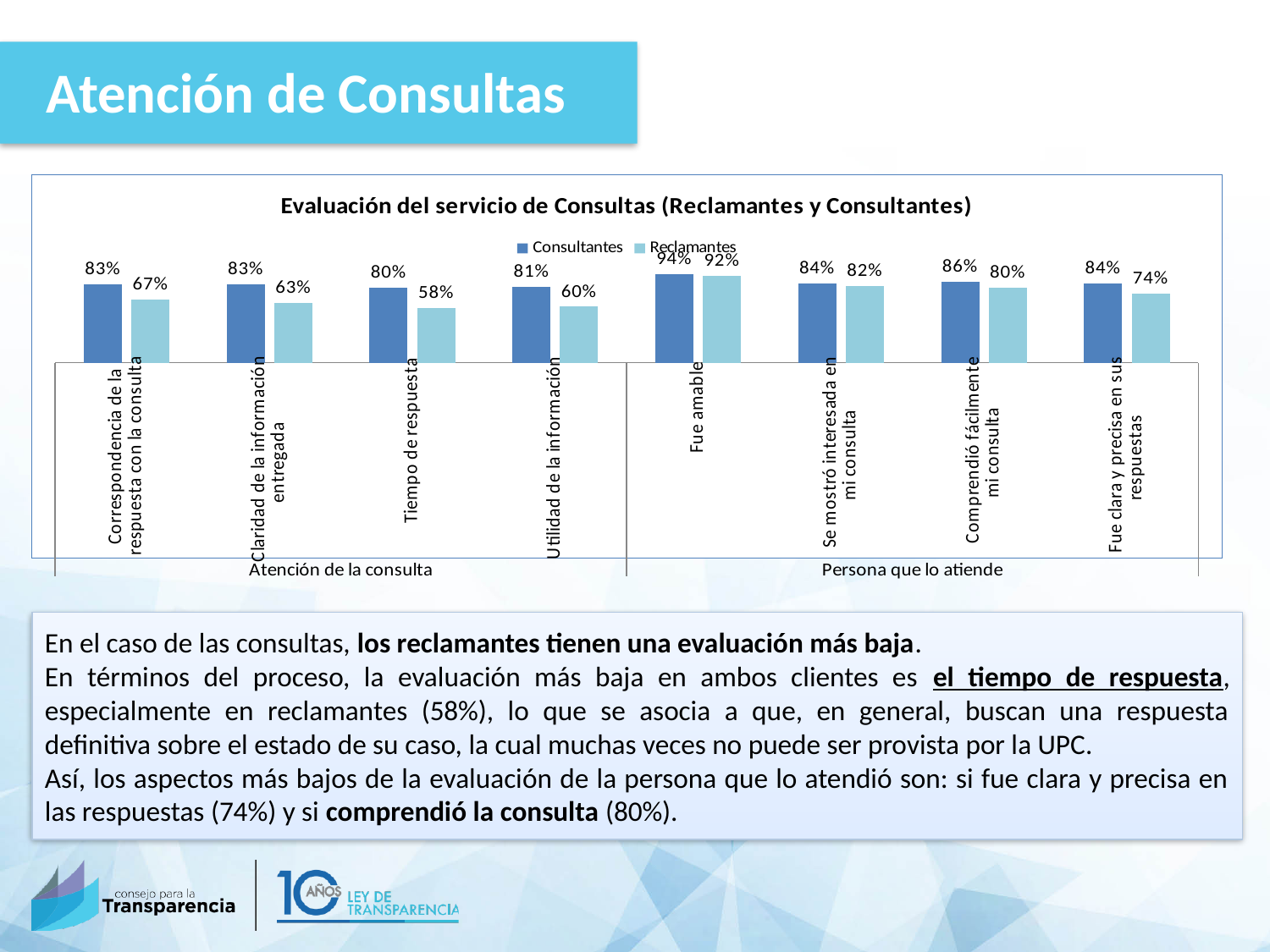
Which category has the lowest Reclamantes value? Tiempo de respuesta How many series does the legend list? 2 What is the title of the chart? Evaluación del servicio de Consultas (Reclamantes y Consultantes) What is the Reclamantes value for Fue clara y precisa en sus respuestas? 74% Which is larger for Comprendió fácilmente mi consulta: the Consultantes value or the Reclamantes value? Consultantes What are the two group labels shown below the categories on the x axis? Atención de la consulta; Persona que lo atiende Which category has the highest Reclamantes value? Fue amable What is the Consultantes value for Fue amable? 94% What is the difference between the Consultantes and Reclamantes values for Claridad de la información entregada? 20% How many categories are shown on the x axis? 8 What is the Reclamantes value for Tiempo de respuesta? 58% What kind of chart is this? Bar chart